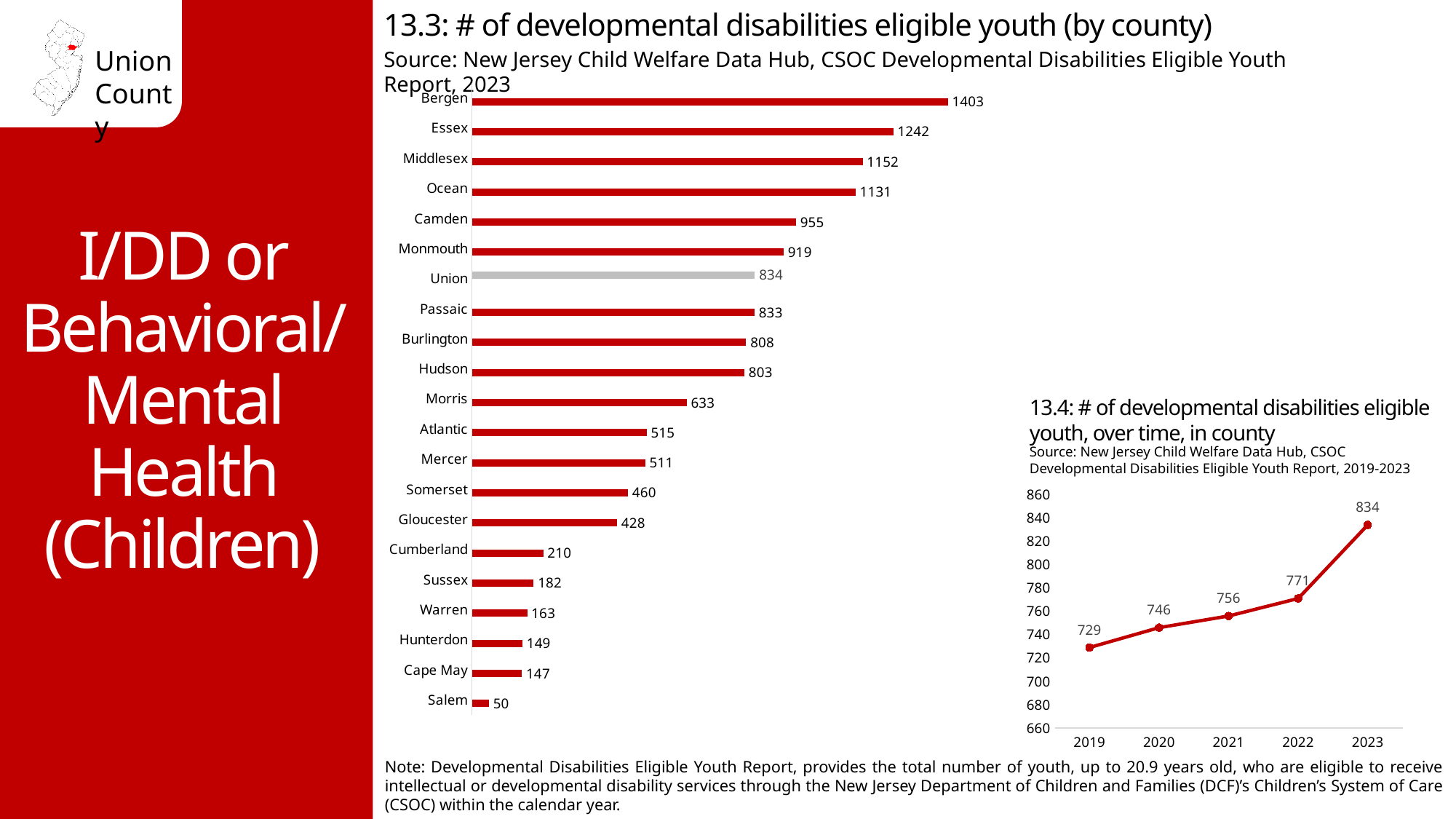
In the chart '13.3: # of developmental disabilities eligible youth (by county)', which county has the lowest value? Salem In the chart '13.3: # of developmental disabilities eligible youth (by county)', what is the value for Gloucester? 428 In the chart '13.4: # of developmental disabilities eligible youth, over time, in county', what is the difference between 2023 and 2019? 105 In the chart '13.3: # of developmental disabilities eligible youth (by county)', which county has the highest value? Bergen In the chart '13.3: # of developmental disabilities eligible youth (by county)', what is the value for Union? 834 What kind of chart is '13.3: # of developmental disabilities eligible youth (by county)'? Bar chart In the chart '13.3: # of developmental disabilities eligible youth (by county)', which is larger, Camden or Monmouth? Camden What kind of chart is '13.4: # of developmental disabilities eligible youth, over time, in county'? Line chart In the chart '13.3: # of developmental disabilities eligible youth (by county)', how many counties are shown? 21 In the chart '13.4: # of developmental disabilities eligible youth, over time, in county', do the values rise or fall from 2019 to 2023? Rise In the chart '13.3: # of developmental disabilities eligible youth (by county)', what is the difference between Bergen and Essex? 161 In the chart '13.4: # of developmental disabilities eligible youth, over time, in county', what is the value for 2021? 756